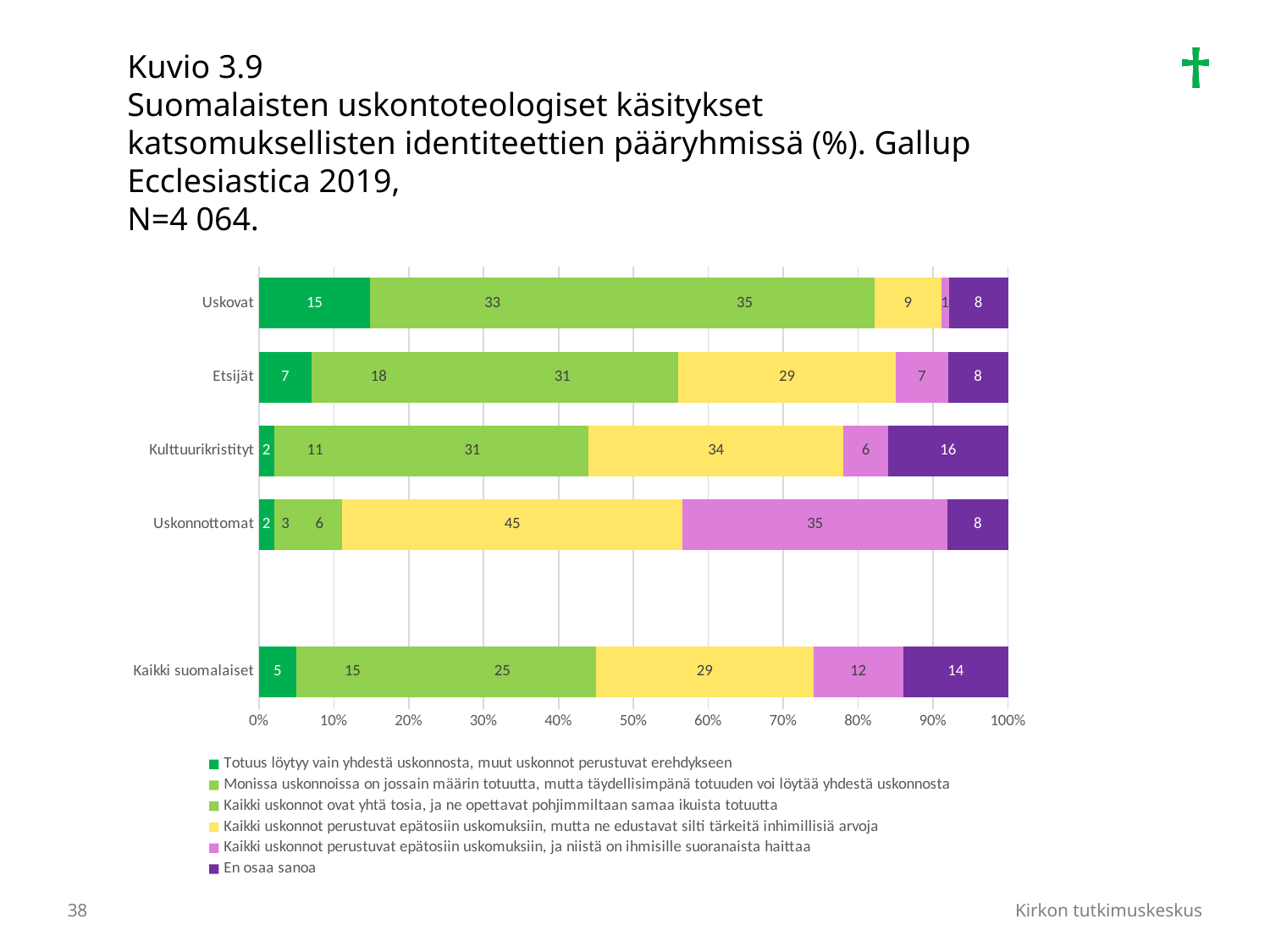
How many series does the legend list? 6 What is the value of 'Totuus löytyy vain yhdestä uskonnosta, muut uskonnot perustuvat erehdykseen' for Uskovat? 15 What is the value of 'Kaikki uskonnot perustuvat epätosiin uskomuksiin, ja niistä on ihmisille suoranaista haittaa' for Uskonnottomat? 35 Which category has the highest value for 'En osaa sanoa'? Kulttuurikristityt Which category has the highest value for 'Totuus löytyy vain yhdestä uskonnosta, muut uskonnot perustuvat erehdykseen'? Uskovat What is the value of 'En osaa sanoa' for Kulttuurikristityt? 16 What is the value of 'Kaikki uskonnot perustuvat epätosiin uskomuksiin, ja niistä on ihmisille suoranaista haittaa' for Kaikki suomalaiset? 12 How many categories (groups) are shown on the vertical axis of the chart? 5 What is the difference between the 'Kaikki uskonnot perustuvat epätosiin uskomuksiin, mutta ne edustavat silti tärkeitä inhimillisiä arvoja' values for Etsijät and Uskovat? 20 What kind of chart is shown on the slide? bar chart Which has the larger 'En osaa sanoa' value, Kaikki suomalaiset or Etsijät? Kaikki suomalaiset What is the value of 'Kaikki uskonnot perustuvat epätosiin uskomuksiin, mutta ne edustavat silti tärkeitä inhimillisiä arvoja' for Uskonnottomat? 45